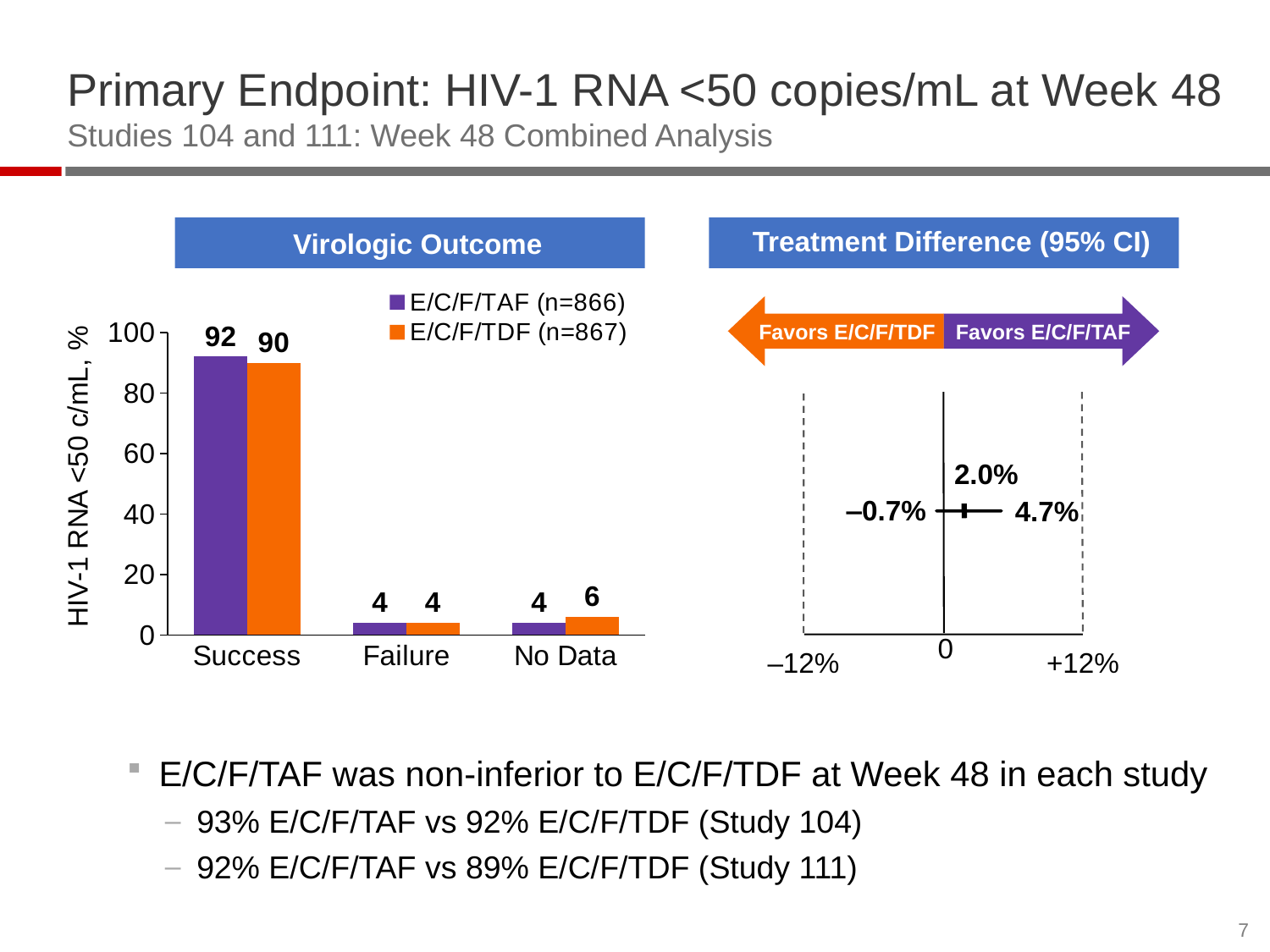
In the Treatment Difference (95% CI) chart, what are the lower and upper bounds of the 95% confidence interval? –0.7% and 4.7% In the Virologic Outcome chart, what is the value for E/C/F/TAF in the Success category? 92 In the Virologic Outcome chart, what is the value for E/C/F/TDF in the Success category? 90 In the Virologic Outcome chart, what is the value for E/C/F/TDF in the No Data category? 6 In the Treatment Difference (95% CI) chart, what is the point estimate of the treatment difference? 2.0% In the Virologic Outcome chart, what is the value for E/C/F/TAF in the Failure category? 4 In the Virologic Outcome chart, how many categories are shown on the x axis? 3 In the Virologic Outcome chart, which series has the larger value in the No Data category? E/C/F/TDF In the Virologic Outcome chart, how many series does the legend list? 2 What kind of chart is the Virologic Outcome chart? Bar chart In the Virologic Outcome chart, what is the difference between the E/C/F/TAF and E/C/F/TDF values for Success? 2 In the Virologic Outcome chart, which category has the highest value for E/C/F/TAF? Success